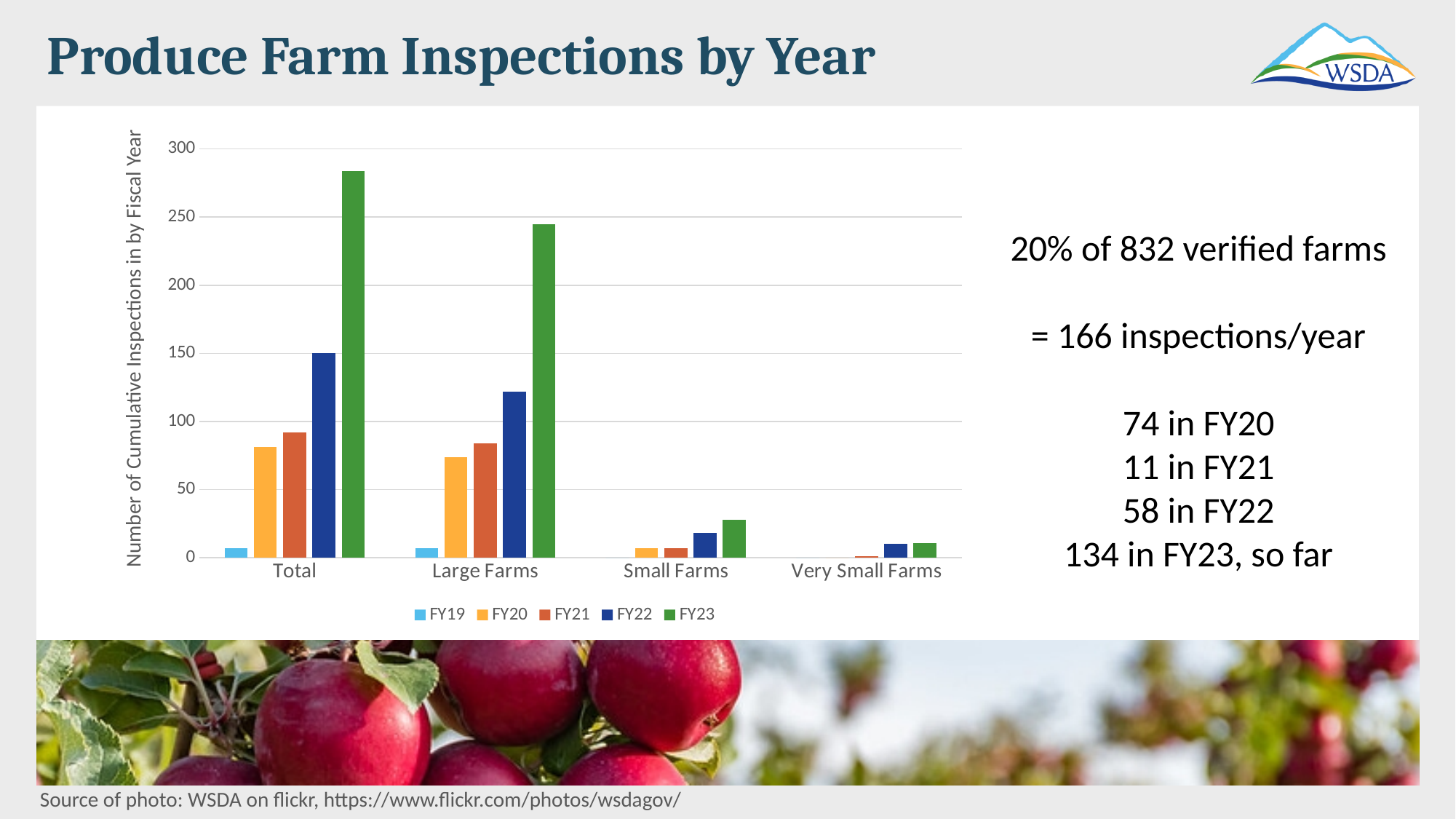
Which fiscal year has the highest bar in the Total category? FY23 Is the FY20 value for Total greater or less than 100? less Is the FY22 value for Large Farms greater or less than 100? greater Within the Total category, do the bars rise or fall from FY19 to FY23? rise How many series does the chart legend list? 5 What is the title of the vertical axis of the chart? Number of Cumulative Inspections in by Fiscal Year What kind of chart is shown on the slide? bar chart How many categories are shown on the x axis of the chart? 4 In the Large Farms category, which is larger, the FY21 bar or the FY22 bar? FY22 Which category has the lowest FY23 bar? Very Small Farms Is the FY23 value for Total greater or less than 250? greater